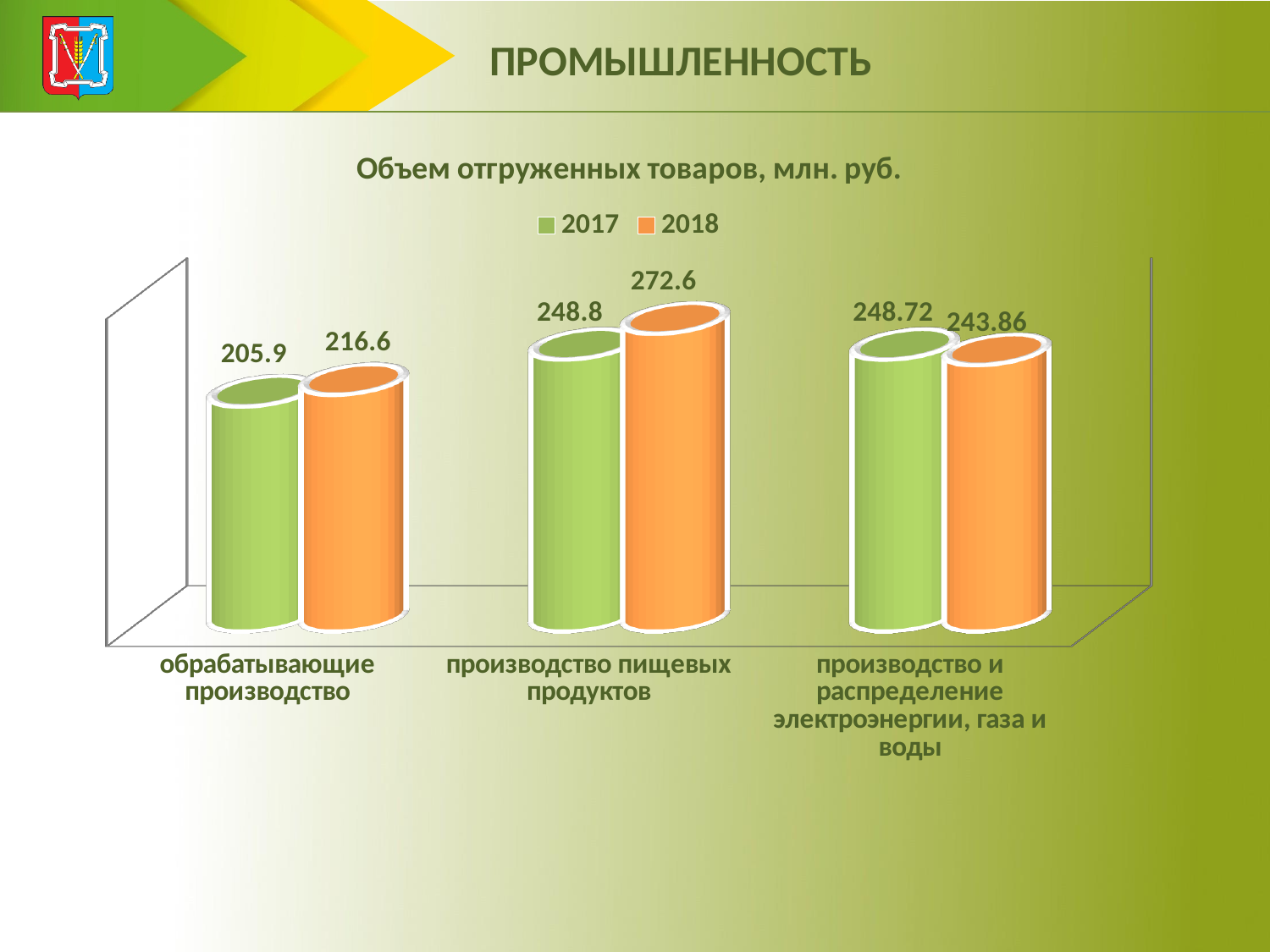
What is the value for 2017 in the category "обрабатывающие производство"? 205.9 For "производство и распределение электроэнергии, газа и воды", which year has the larger value, 2017 or 2018? 2017 What is the 2018 value for "производство и распределение электроэнергии, газа и воды"? 243.86 What is the difference between the 2018 and 2017 values for "производство пищевых продуктов"? 23.8 How many categories are shown on the x axis? 3 What kind of chart is shown on the slide? bar chart Which category has the lowest 2017 value? обрабатывающие производство What is the value for 2018 in the category "производство пищевых продуктов"? 272.6 What is the title of the chart? Объем отгруженных товаров, млн. руб. What is the difference between the 2018 and 2017 values for "обрабатывающие производство"? 10.7 How many series does the legend list? 2 Which category has the highest 2018 value? производство пищевых продуктов